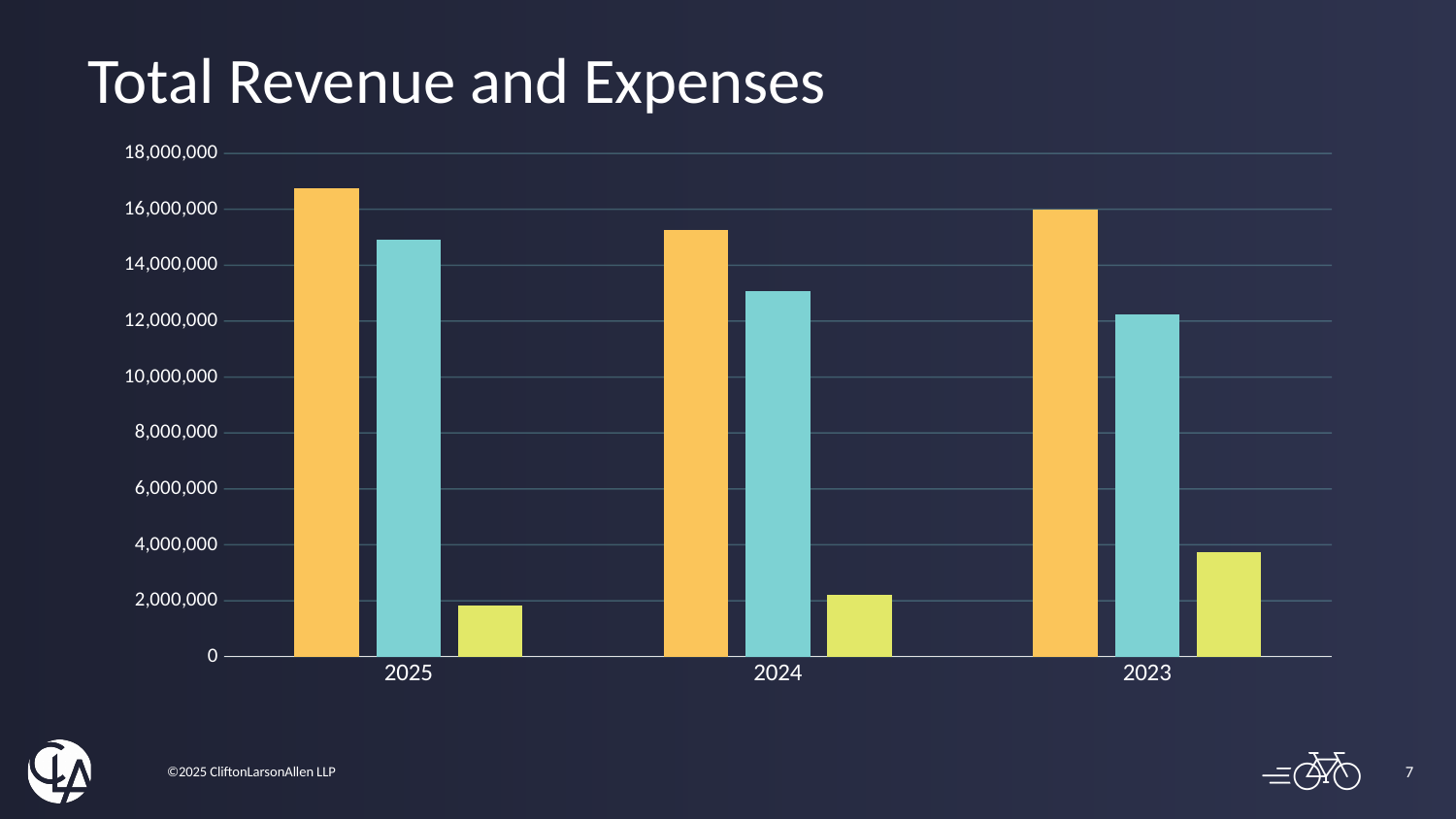
Is the value of the orange bar for 2024 greater or less than 16,000,000? less Which year has the shortest teal bar? 2023 In 2025, which is larger: the orange bar or the teal bar? the orange bar Which year has the tallest orange bar? 2025 How many bars are plotted for each year in the chart? 3 Do the teal bars rise or fall moving left to right along the x axis from 2025 to 2023? fall Is the value of the teal bar for 2025 greater or less than 14,000,000? greater What is the title of the chart? Total Revenue and Expenses Is the value of the orange bar for 2025 greater or less than 16,000,000? greater How many years are shown on the x axis of the chart? 3 What kind of chart is shown on the slide? bar chart